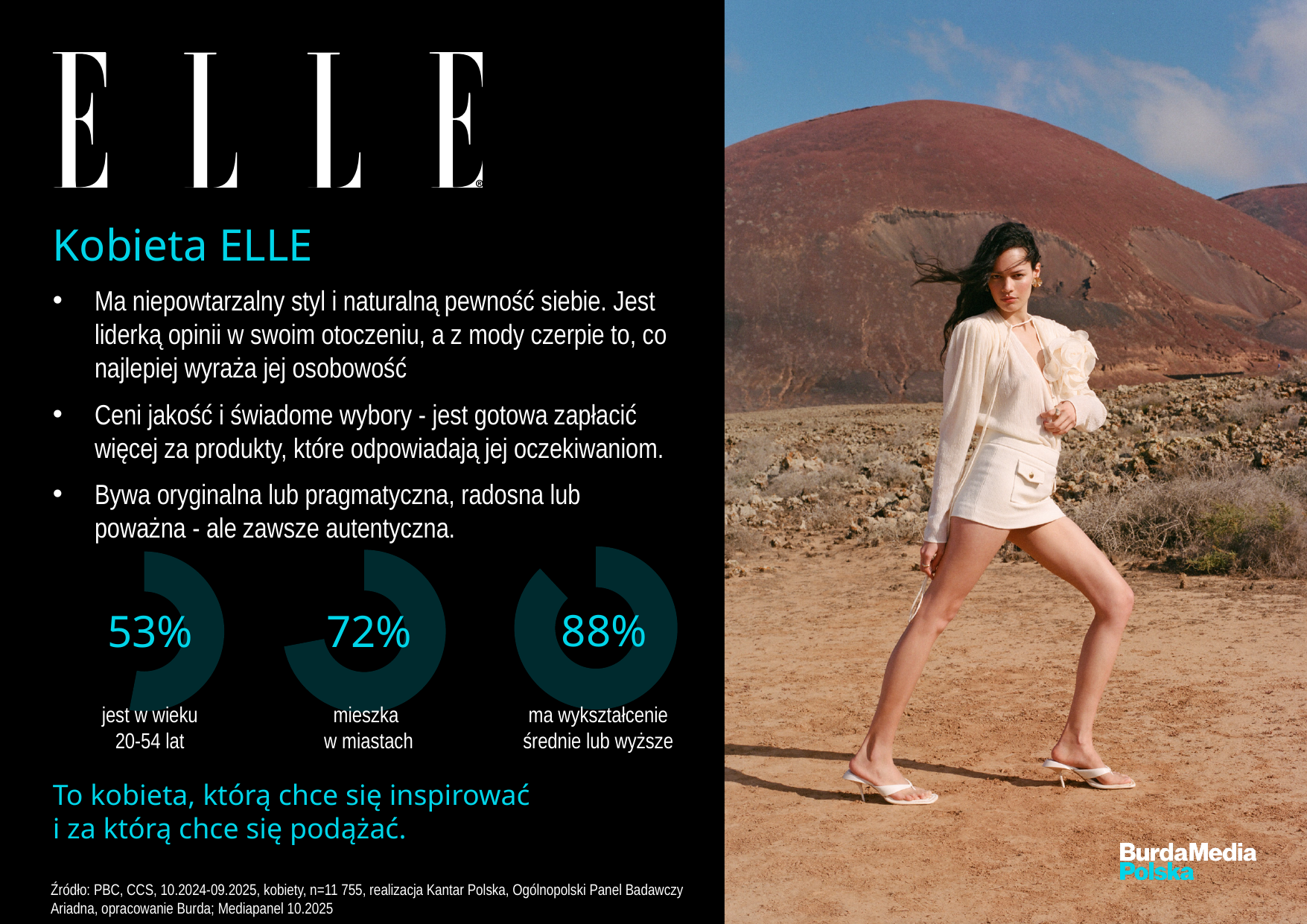
Which of the three donut charts shows the highest percentage? ma wykształcenie średnie lub wyższe (88%) What percentage of ELLE women live in cities ("mieszka w miastach"), according to the middle donut chart? 72% How many donut charts are shown on the slide? 3 Is the percentage shown in the right donut chart ("ma wykształcenie średnie lub wyższe") greater or less than 80%? greater Which of the three donut charts shows the lowest percentage? jest w wieku 20-54 lat (53%) What is the difference between the percentage for "mieszka w miastach" and the percentage for "jest w wieku 20-54 lat"? 19% Which is larger: the percentage for "mieszka w miastach" or the percentage for "jest w wieku 20-54 lat"? mieszka w miastach What type of chart is used to show the 53%, 72% and 88% figures? Donut chart What percentage of ELLE women have secondary or higher education ("ma wykształcenie średnie lub wyższe"), according to the right donut chart? 88% What is the difference between the percentage for "ma wykształcenie średnie lub wyższe" and the percentage for "mieszka w miastach"? 16% What colour is the filled portion of the donut charts? Dark teal What percentage of ELLE women are aged 20-54 ("jest w wieku 20-54 lat"), according to the left donut chart? 53%